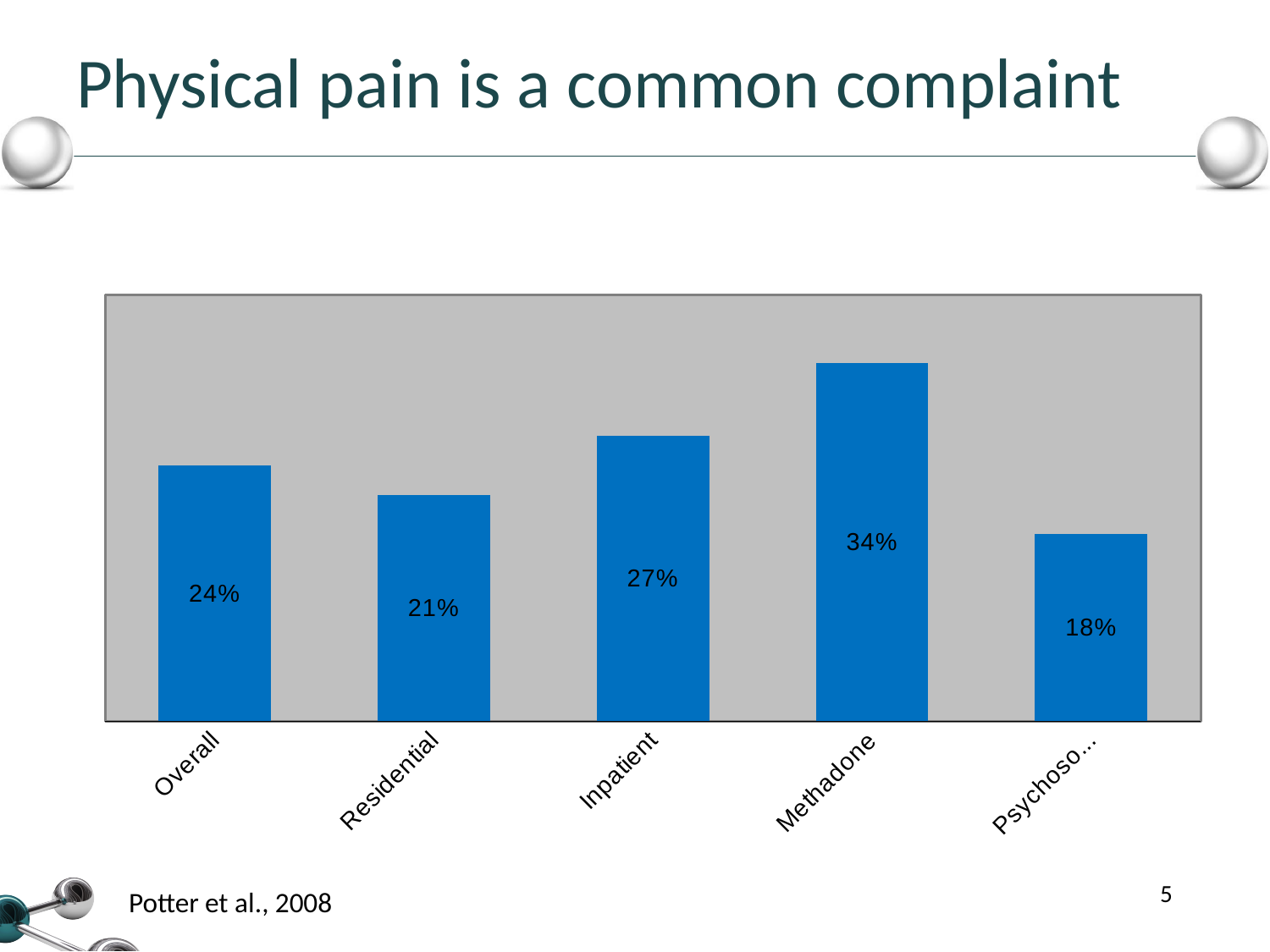
What is the value for Overall? 24% Which category has the highest value? Methadone What kind of chart is shown on the slide? Bar chart What is the value for Inpatient? 27% Which is larger, the value for Inpatient or the value for Residential? Inpatient What is the value shown on the rightmost bar? 18% What is the value for Methadone? 34% How many bars are shown in the chart? 5 Which of the labelled categories has the lowest value among Overall, Residential, Inpatient and Methadone? Residential What is the value for Residential? 21% What is the difference between the values for Methadone and Residential? 13% What is the difference between the values for Inpatient and Overall? 3%